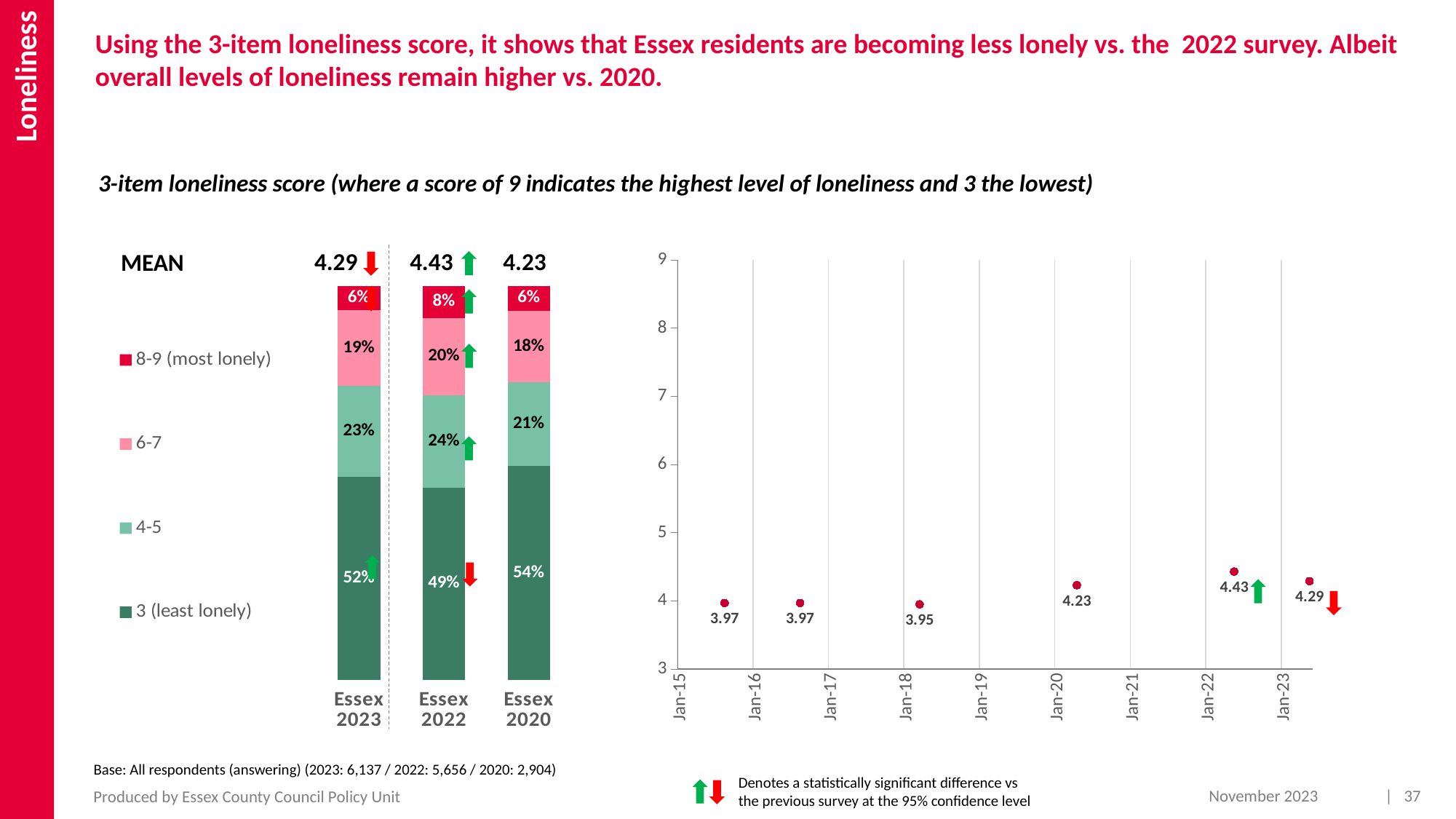
In the stacked bar chart on the left, what percentage of Essex 2023 respondents scored 3 (least lonely)? 52% How many series does the legend of the stacked bar chart on the left list? 4 In the stacked bar chart on the left, is the 4-5 share larger for Essex 2023 or Essex 2022? Essex 2022 In the stacked bar chart on the left, which survey year has the highest share of respondents scoring 3 (least lonely)? Essex 2020 In the chart on the right, what is the difference between the highest plotted value (4.43) and the latest value (4.29)? 0.14 What type of chart is shown on the left of the slide? Stacked bar chart How many data points are plotted in the chart on the right? 6 In the stacked bar chart on the left, what percentage of Essex 2020 respondents scored 4-5? 21% What is the mean 3-item loneliness score shown for Essex 2022 in the left chart? 4.43 In the chart on the right, what is the lowest mean loneliness score plotted? 3.95 In the stacked bar chart on the left, what is the difference in the 6-7 share between Essex 2022 and Essex 2020? 2 percentage points In the stacked bar chart on the left, what percentage of Essex 2022 respondents scored 8-9 (most lonely)? 8%